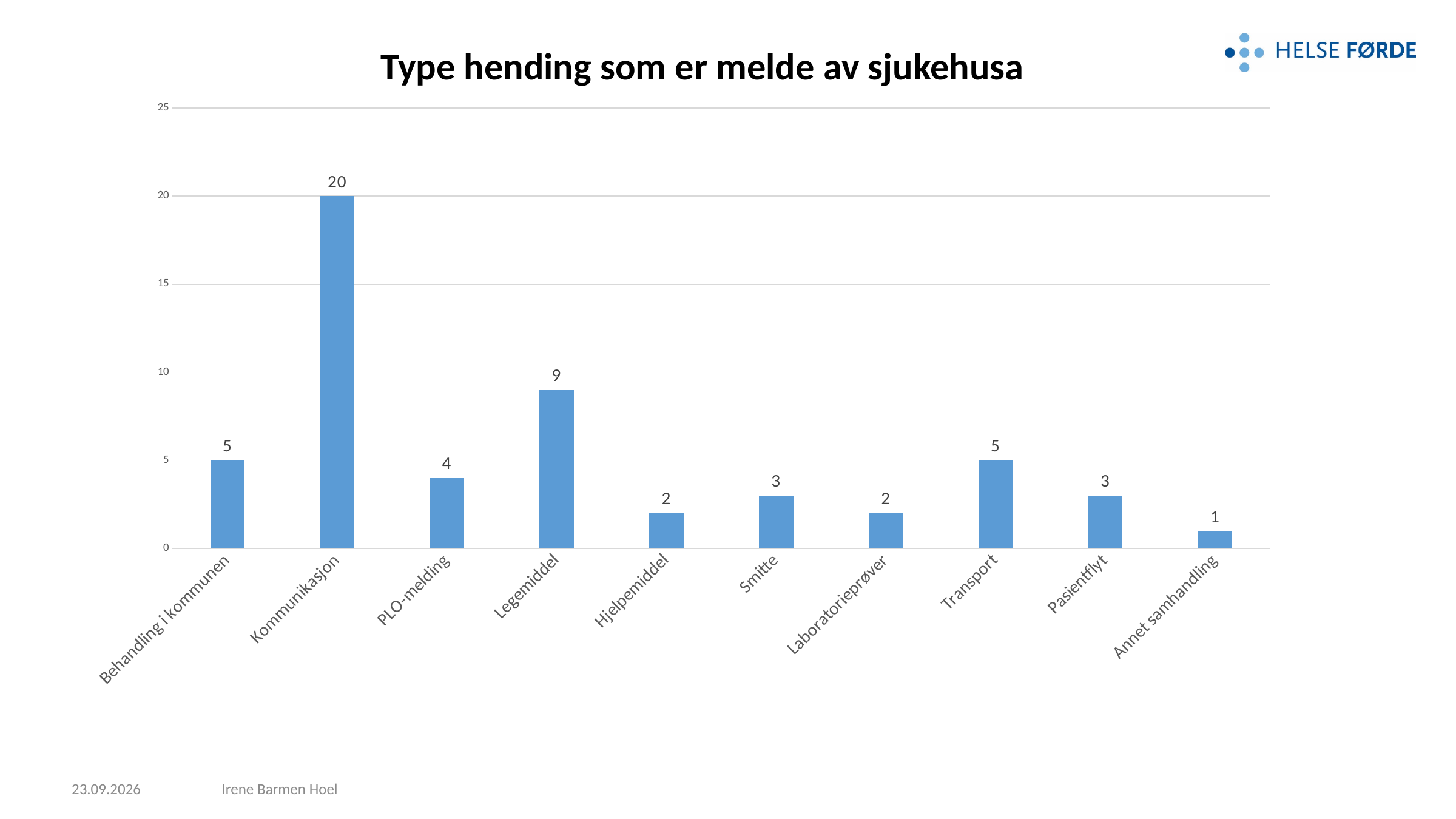
What is the difference between the values for Kommunikasjon and Legemiddel? 11 How many categories are shown on the x axis? 10 What is the value for PLO-melding? 4 What is the value for Annet samhandling? 1 What is the value for Kommunikasjon? 20 What is the value for Legemiddel? 9 What kind of chart is shown on the slide? bar chart What is the title of the chart? Type hending som er melde av sjukehusa Which category has the highest value? Kommunikasjon Is the value for Legemiddel greater or less than 10? less Which category has the lowest value? Annet samhandling Which is larger, the value for Transport or the value for Pasientflyt? Transport